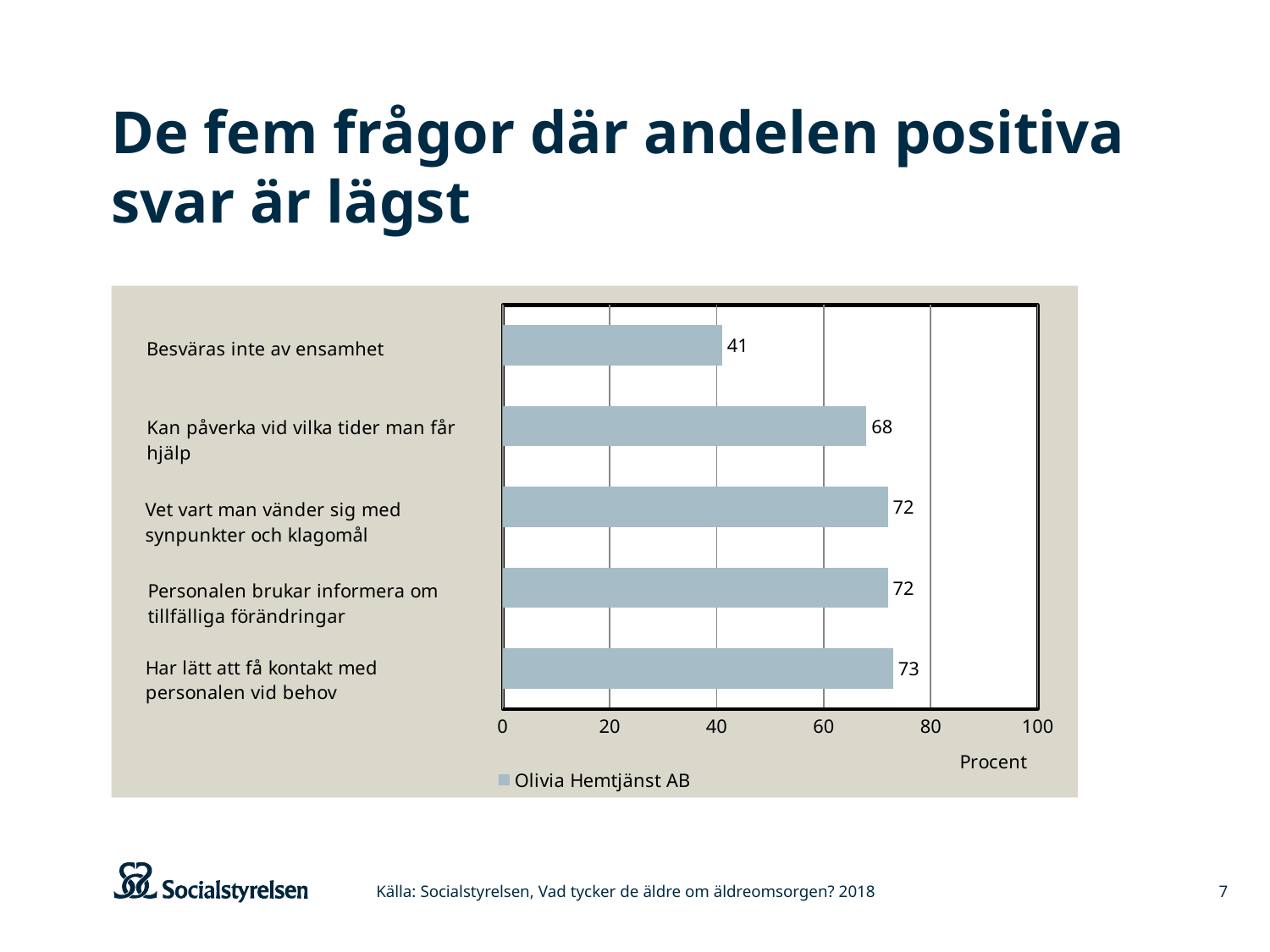
What is the difference between the values for "Kan påverka vid vilka tider man får hjälp" and "Besväras inte av ensamhet"? 27 What series name does the legend show? Olivia Hemtjänst AB Which is larger: the value for "Kan påverka vid vilka tider man får hjälp" or the value for "Besväras inte av ensamhet"? Kan påverka vid vilka tider man får hjälp What kind of chart is shown on the slide? bar chart Is the value for "Besväras inte av ensamhet" greater or less than 60? less What is the value for "Har lätt att få kontakt med personalen vid behov"? 73 What is the value for "Vet vart man vänder sig med synpunkter och klagomål"? 72 How many categories are shown in the chart? 5 What is the value for "Kan påverka vid vilka tider man får hjälp"? 68 Which category has the lowest value? Besväras inte av ensamhet What is the value for "Besväras inte av ensamhet"? 41 Which category has the highest value? Har lätt att få kontakt med personalen vid behov